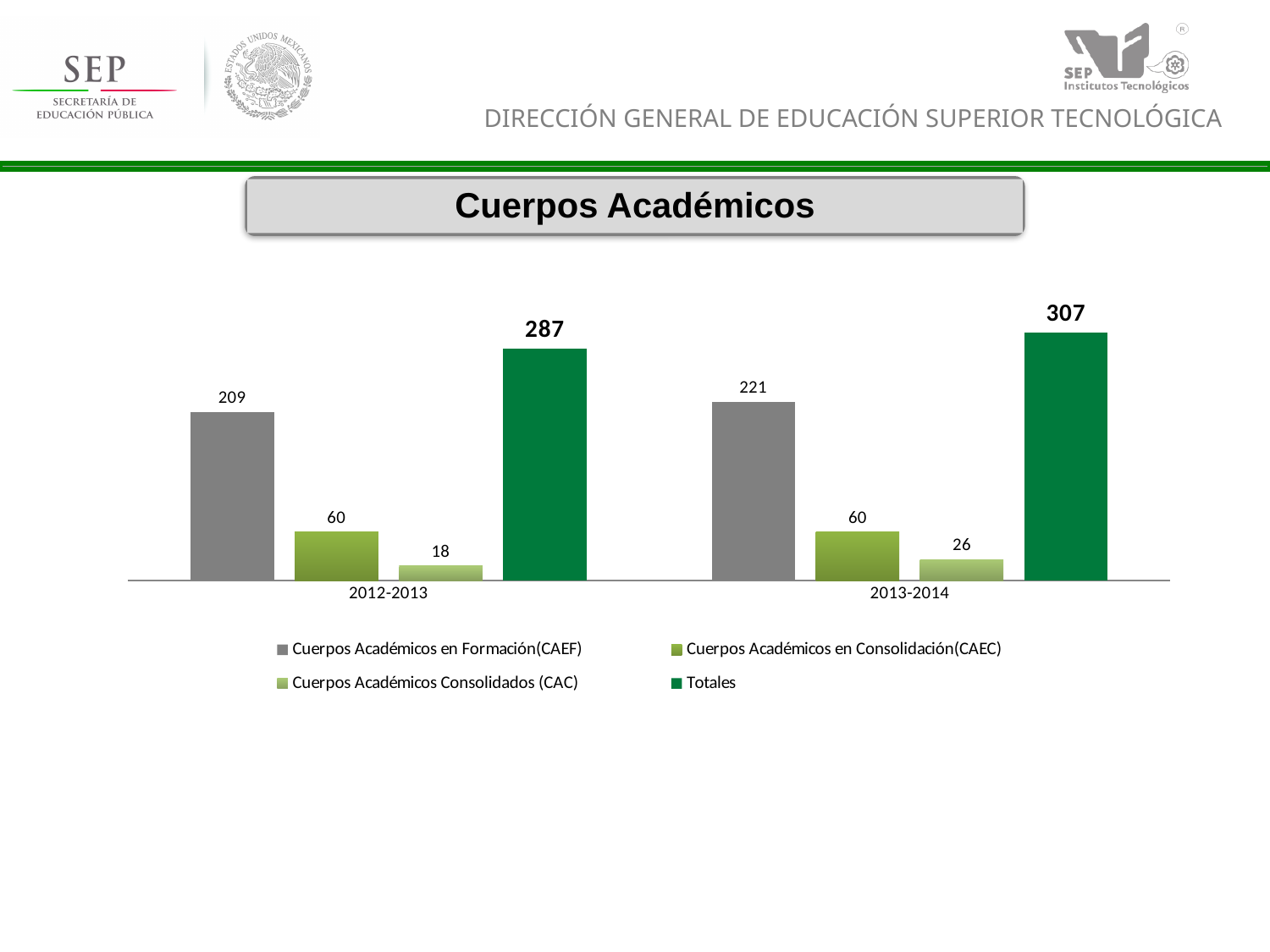
What is the value for Cuerpos Académicos Consolidados (CAC) in 2013-2014? 26 Which is larger: the CAC value in 2012-2013 or the CAC value in 2013-2014? 2013-2014 Which series has the lowest value in 2012-2013? Cuerpos Académicos Consolidados (CAC) How many categories are shown on the x axis? 2 How many series does the legend list? 4 What is the value for Cuerpos Académicos en Formación (CAEF) in 2012-2013? 209 What is the difference between the Totales values for 2013-2014 and 2012-2013? 20 Which series has the highest value in 2013-2014? Totales What is the value for Totales in 2013-2014? 307 What is the value for Cuerpos Académicos en Consolidación (CAEC) in 2012-2013? 60 What kind of chart is shown on the slide? Bar chart What is the difference between the CAEF values for 2013-2014 and 2012-2013? 12